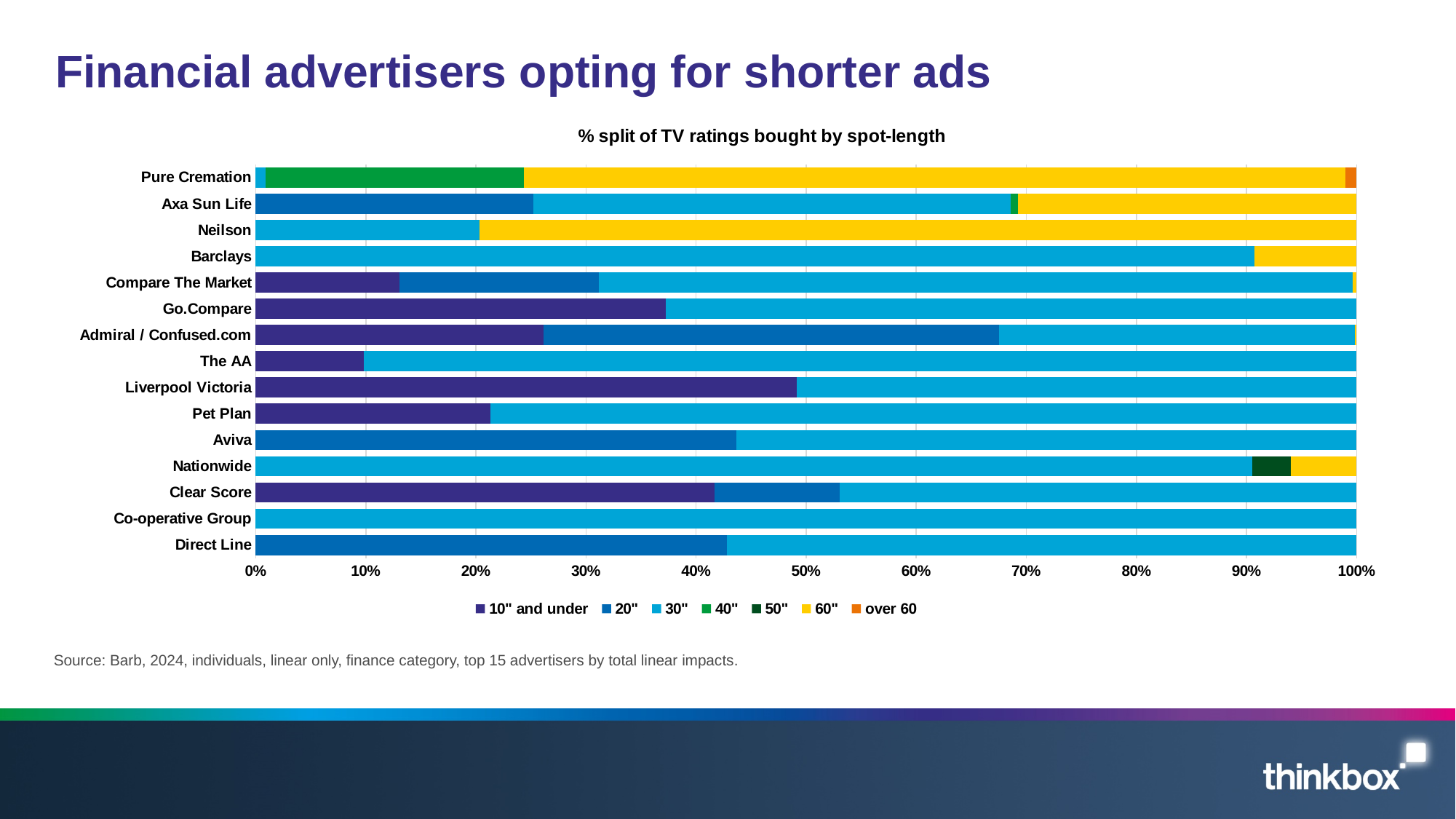
How many spot-length series does the legend list? 7 What is the title of the chart? % split of TV ratings bought by spot-length Which advertiser has a larger 10" and under share, Liverpool Victoria or Pet Plan? Liverpool Victoria Which advertiser's bar is made up entirely of the 30" series? Co-operative Group How many advertisers are listed on the chart? 15 Is the 20" share for Direct Line greater or less than 40%? greater Is the 10" and under share for The AA greater or less than 20%? less What kind of chart is shown on the slide? bar chart Is the 10" and under share for Go.Compare greater or less than 30%? greater Which advertiser has the largest 10" and under share? Liverpool Victoria